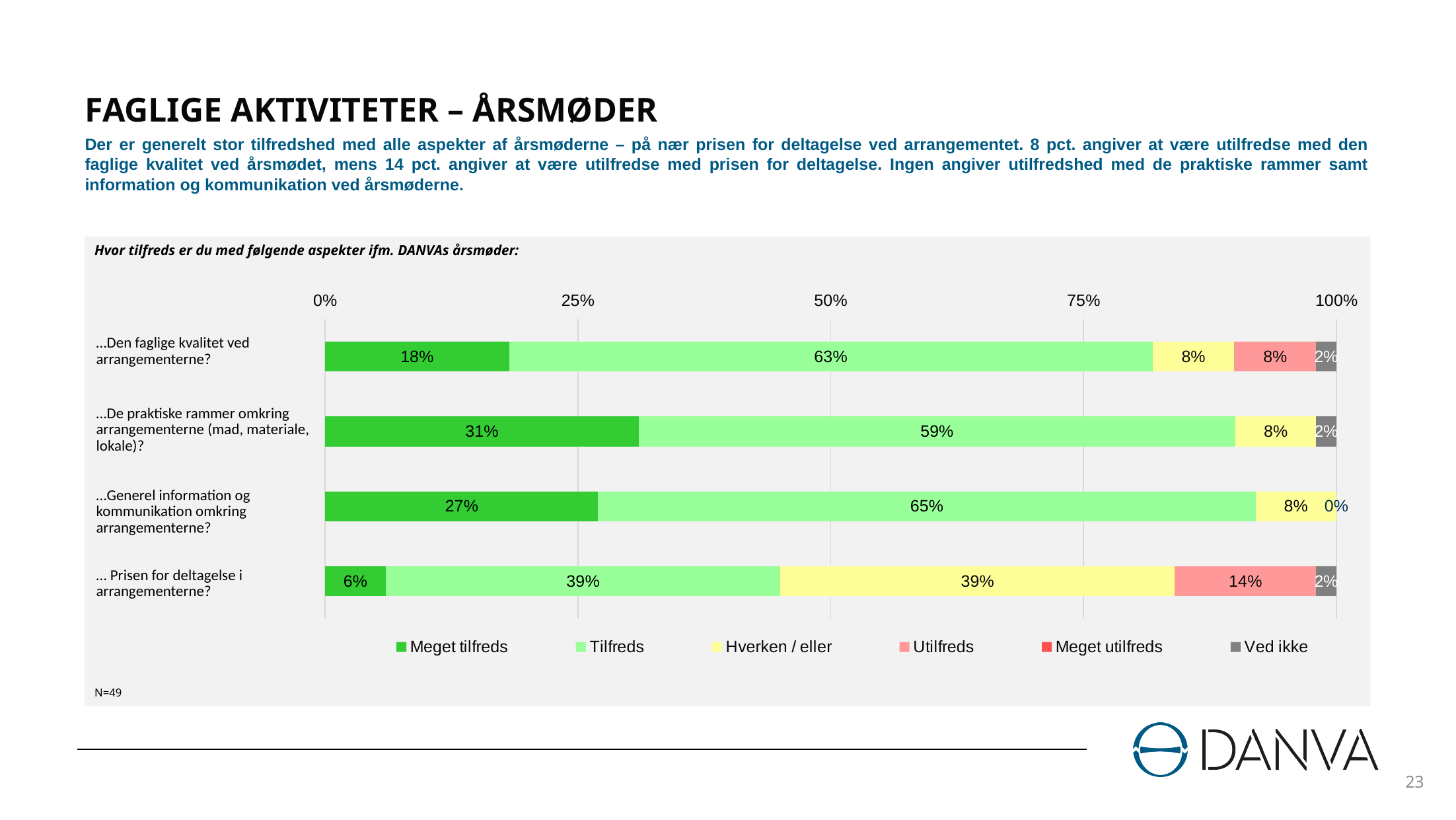
What is the 'Utilfreds' value for '... Prisen for deltagelse i arrangementerne?'? 14% Which category has the lowest 'Meget tilfreds' value? ... Prisen for deltagelse i arrangementerne? What kind of chart is shown on the slide? Stacked bar chart How many series does the legend list? 6 Which is larger: the 'Meget tilfreds' value for '...Den faglige kvalitet ved arrangementerne?' or for '...Generel information og kommunikation omkring arrangementerne?'? ...Generel information og kommunikation omkring arrangementerne? What is the sample size (N) stated below the chart? N=49 Which category has the highest 'Meget tilfreds' value? ...De praktiske rammer omkring arrangementerne (mad, materiale, lokale)? What is the difference between the 'Tilfreds' values for '...Generel information og kommunikation omkring arrangementerne?' and '... Prisen for deltagelse i arrangementerne?'? 26% What is the 'Tilfreds' value for '...Generel information og kommunikation omkring arrangementerne?'? 65% What is the 'Hverken / eller' value for '... Prisen for deltagelse i arrangementerne?'? 39% What is the 'Meget tilfreds' value for '...De praktiske rammer omkring arrangementerne (mad, materiale, lokale)?'? 31% How many categories (aspects) are shown in the chart? 4